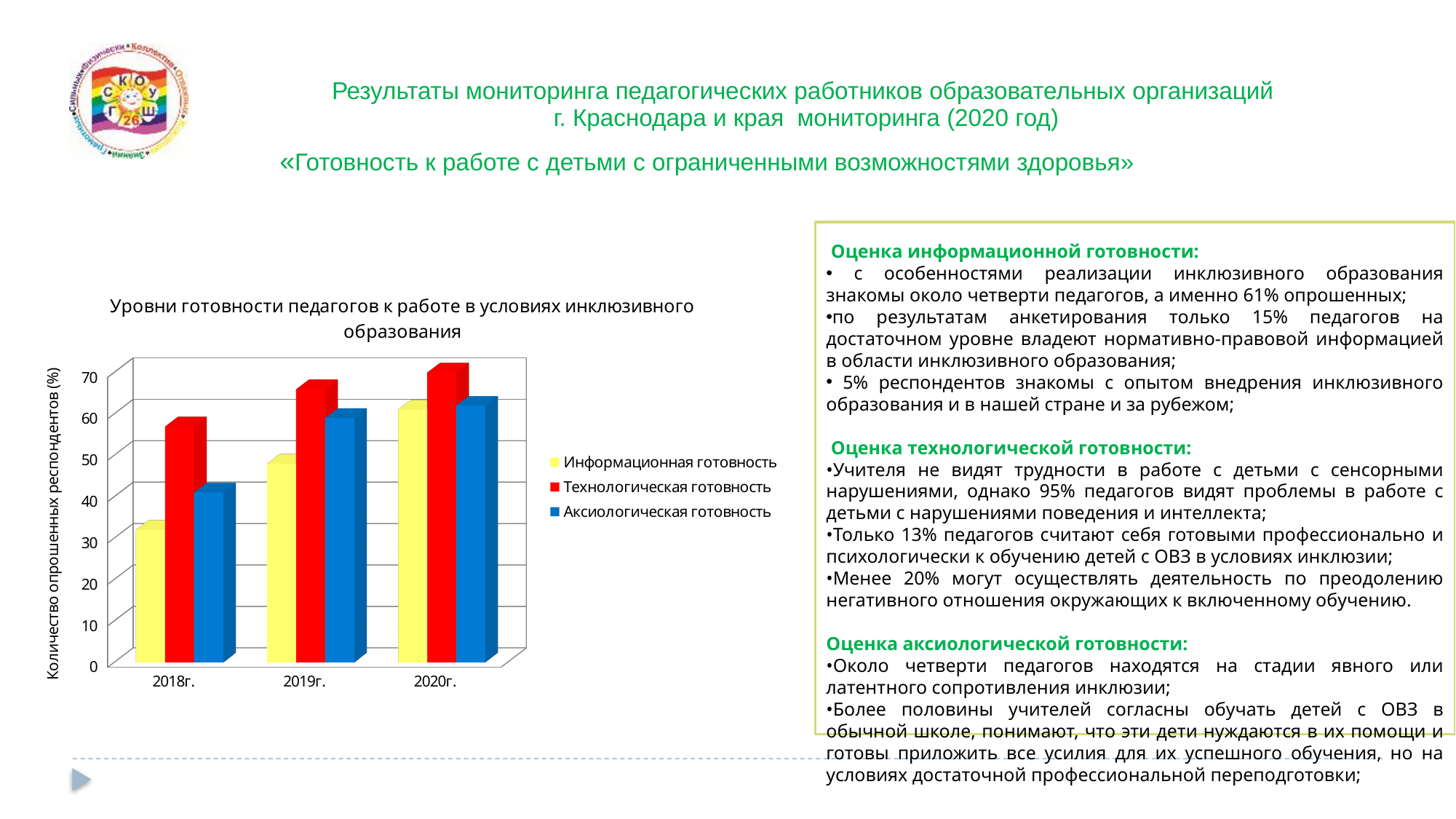
Which series is shown in red in the chart? Технологическая готовность What is the title of the chart? Уровни готовности педагогов к работе в условиях инклюзивного образования Does the value for Информационная готовность rise or fall from 2018г. to 2020г.? rises How many year categories are shown on the x axis of the chart? 3 Which series has the lowest value in 2018г.? Информационная готовность Which is larger in 2019г., Технологическая готовность or Аксиологическая готовность? Технологическая готовность How many series does the chart legend list? 3 What kind of chart is shown on the slide? bar chart In which year is the value for Технологическая готовность highest? 2020г. Which series has the highest value in 2018г.? Технологическая готовность Is the value for Информационная готовность in 2018г. greater or less than 40? less Is the value for Технологическая готовность in 2019г. greater or less than 60? greater